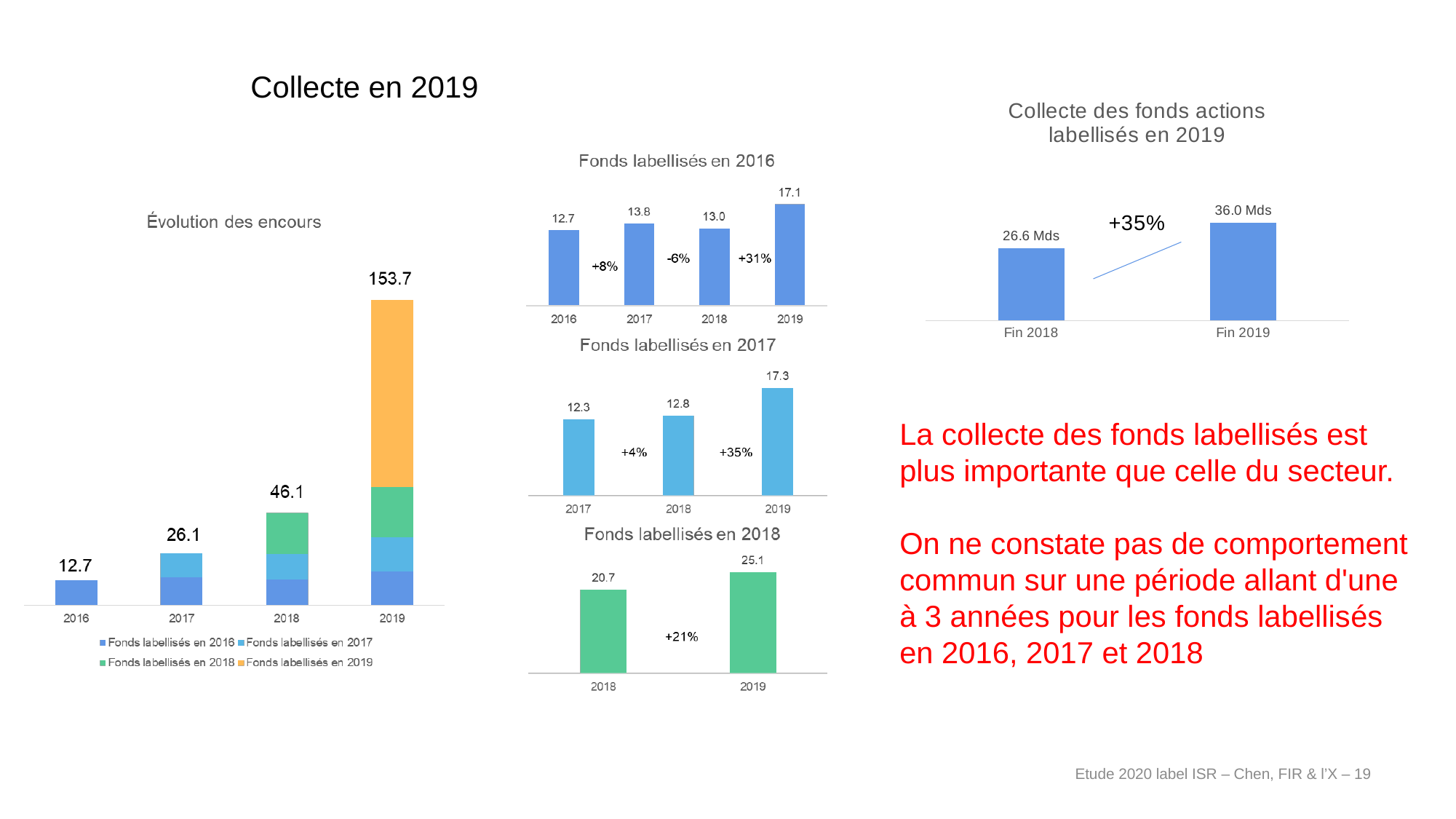
In the 'Collecte des fonds actions labellisés en 2019' chart, what is the value for Fin 2019? 36.0 Mds How many years are plotted in the 'Fonds labellisés en 2017' chart? 3 In the 'Fonds labellisés en 2016' chart, which year has the highest value? 2019 In the 'Fonds labellisés en 2016' chart, what is the value for 2019? 17.1 In the 'Fonds labellisés en 2016' chart, what is the difference between the 2019 and 2018 values? 4.1 In the 'Collecte des fonds actions labellisés en 2019' chart, which is larger, Fin 2018 or Fin 2019? Fin 2019 In the 'Évolution des encours' chart, what is the total value shown for 2019? 153.7 In the 'Évolution des encours' chart, do the totals rise or fall from 2016 to 2019? Rise In the 'Fonds labellisés en 2018' chart, what is the difference between the 2019 and 2018 values? 4.4 In the 'Évolution des encours' chart, how many series does the legend list? 4 What kind of chart is 'Évolution des encours'? Stacked bar chart In the 'Fonds labellisés en 2017' chart, what is the value for 2018? 12.8